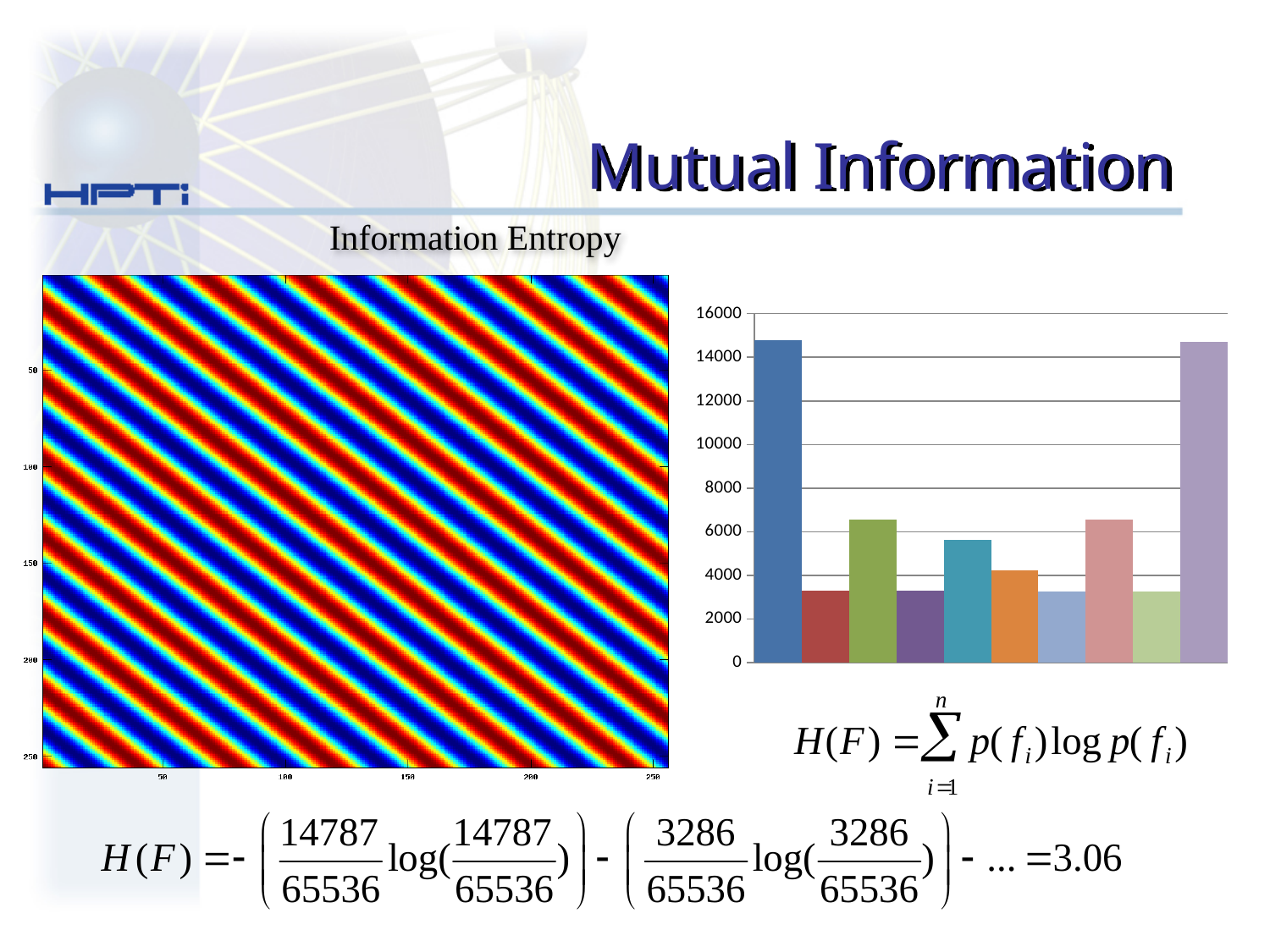
In the bar chart, which is larger: the first bar from the left or the second bar from the left? the first bar In the bar chart, is the value of the second bar from the left greater or less than 4000? less In the bar chart, is the value of the first (leftmost) bar greater or less than 14000? greater In the bar chart, is the value of the third bar from the left greater or less than 6000? greater How many bars does the bar chart on the right contain? 10 What kind of chart is shown on the right side of the slide? bar chart What is the highest value shown on the vertical axis of the bar chart? 16000 What is the interval between consecutive tick marks on the vertical axis of the bar chart? 2000 In the bar chart, which is larger: the third bar from the left or the fifth bar from the left? the third bar In the bar chart, which is larger: the sixth bar from the left or the eighth bar from the left? the eighth bar